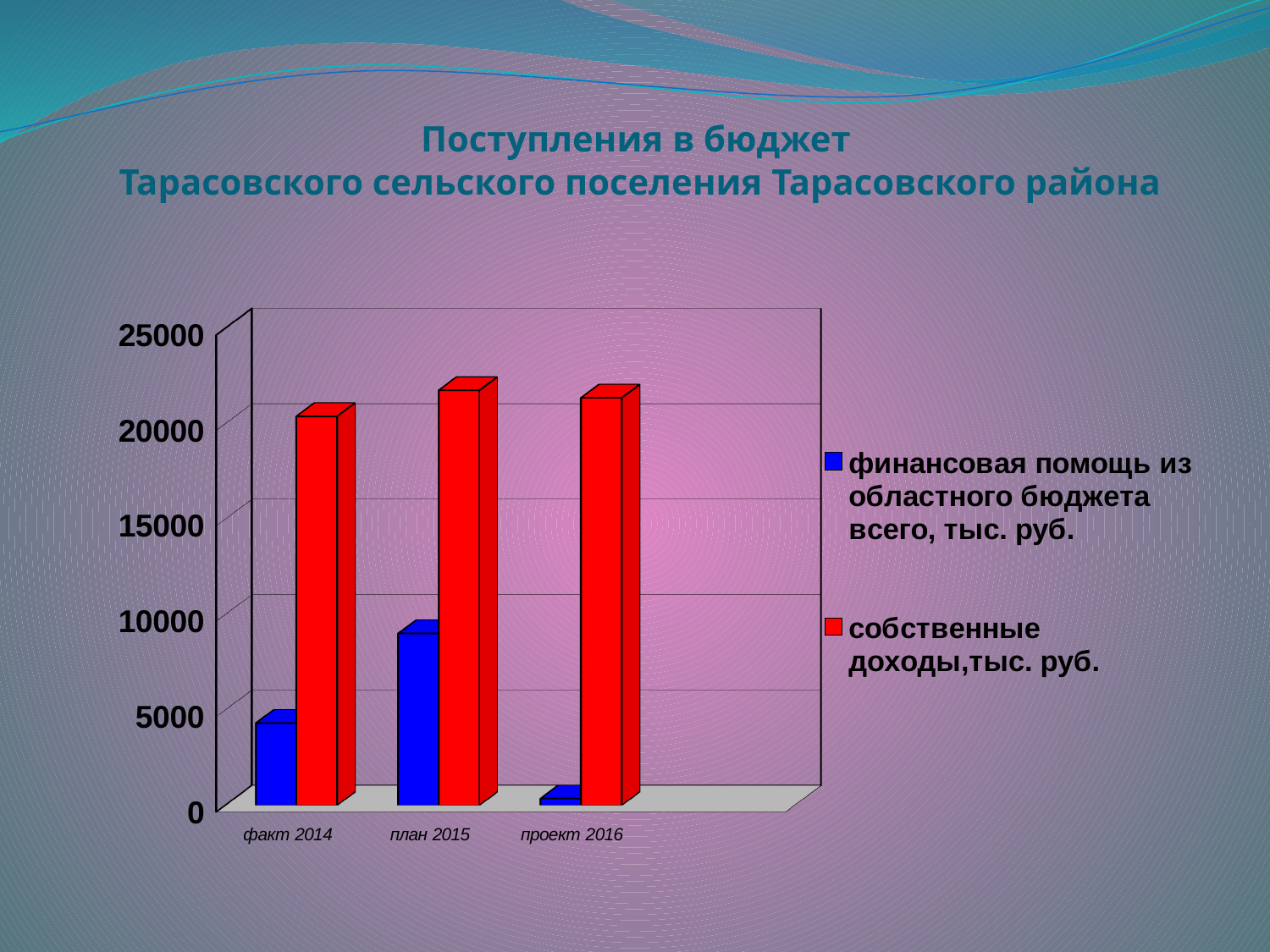
Is the value of финансовая помощь из областного бюджета for проект 2016 greater or less than 5000? less Is the value of собственные доходы for план 2015 greater or less than 20000? greater For план 2015, which is larger: собственные доходы or финансовая помощь из областного бюджета? собственные доходы Is the value of собственные доходы for факт 2014 greater or less than 15000? greater In which category is финансовая помощь из областного бюджета the lowest? проект 2016 In which category is собственные доходы the lowest? факт 2014 What kind of chart is shown on the slide? bar chart In which category is финансовая помощь из областного бюджета the highest? план 2015 How many categories are shown on the x axis of the chart? 3 How many series does the chart's legend list? 2